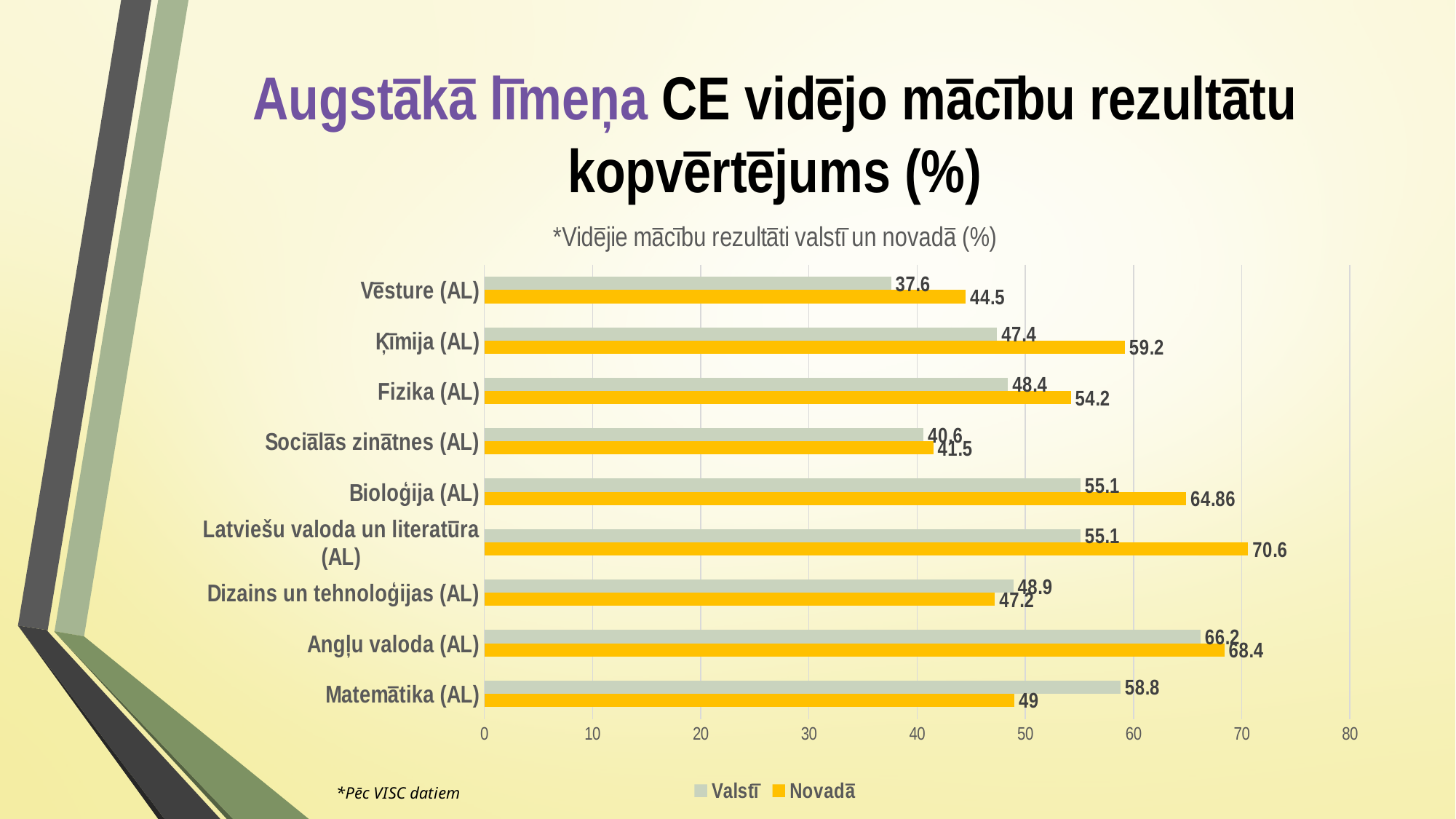
What is the difference between the Novadā and Valstī values for Ķīmija (AL)? 11.8 Which category has the highest Novadā value? Latviešu valoda un literatūra (AL) How many categories are shown on the chart? 9 What kind of chart is shown on the slide? bar chart Is the Novadā value for Vēsture (AL) greater or less than 50? less For Matemātika (AL), which is larger: the Valstī value or the Novadā value? Valstī Which category has the highest Valstī value? Angļu valoda (AL) Which category has the lowest Valstī value? Vēsture (AL) What is the Novadā value for Bioloģija (AL)? 64.86 What is the Valstī value for Ķīmija (AL)? 47.4 What is the Novadā value for Latviešu valoda un literatūra (AL)? 70.6 How many series does the legend list? 2